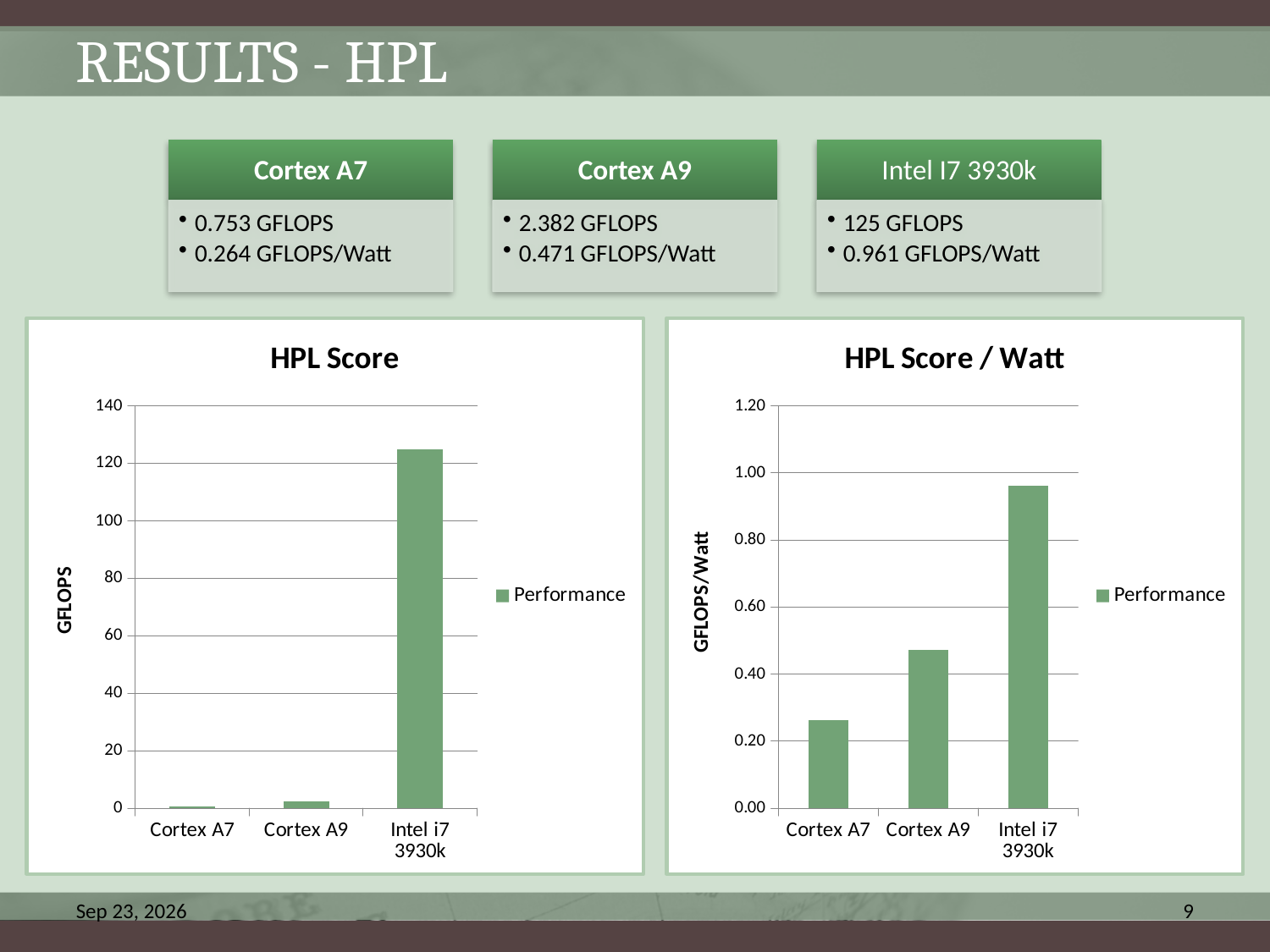
What type of chart is the HPL Score / Watt chart? bar chart On the HPL Score chart, which category has the highest value? Intel i7 3930k On the HPL Score / Watt chart, which category has the highest value? Intel i7 3930k On the HPL Score / Watt chart, which category has the lowest value? Cortex A7 On the HPL Score chart, which category has the lowest value? Cortex A7 What is the y-axis label of the HPL Score / Watt chart? GFLOPS/Watt How many series does the legend of the HPL Score chart list? 1 On the HPL Score / Watt chart, is the value for Cortex A9 greater or less than 0.40? greater On the HPL Score chart, is the value for Intel i7 3930k greater or less than 120? greater On the HPL Score / Watt chart, which is larger, the value for Cortex A9 or the value for Cortex A7? Cortex A9 How many categories are shown on the HPL Score chart? 3 On the HPL Score / Watt chart, is the value for Intel i7 3930k greater or less than 1.00? less